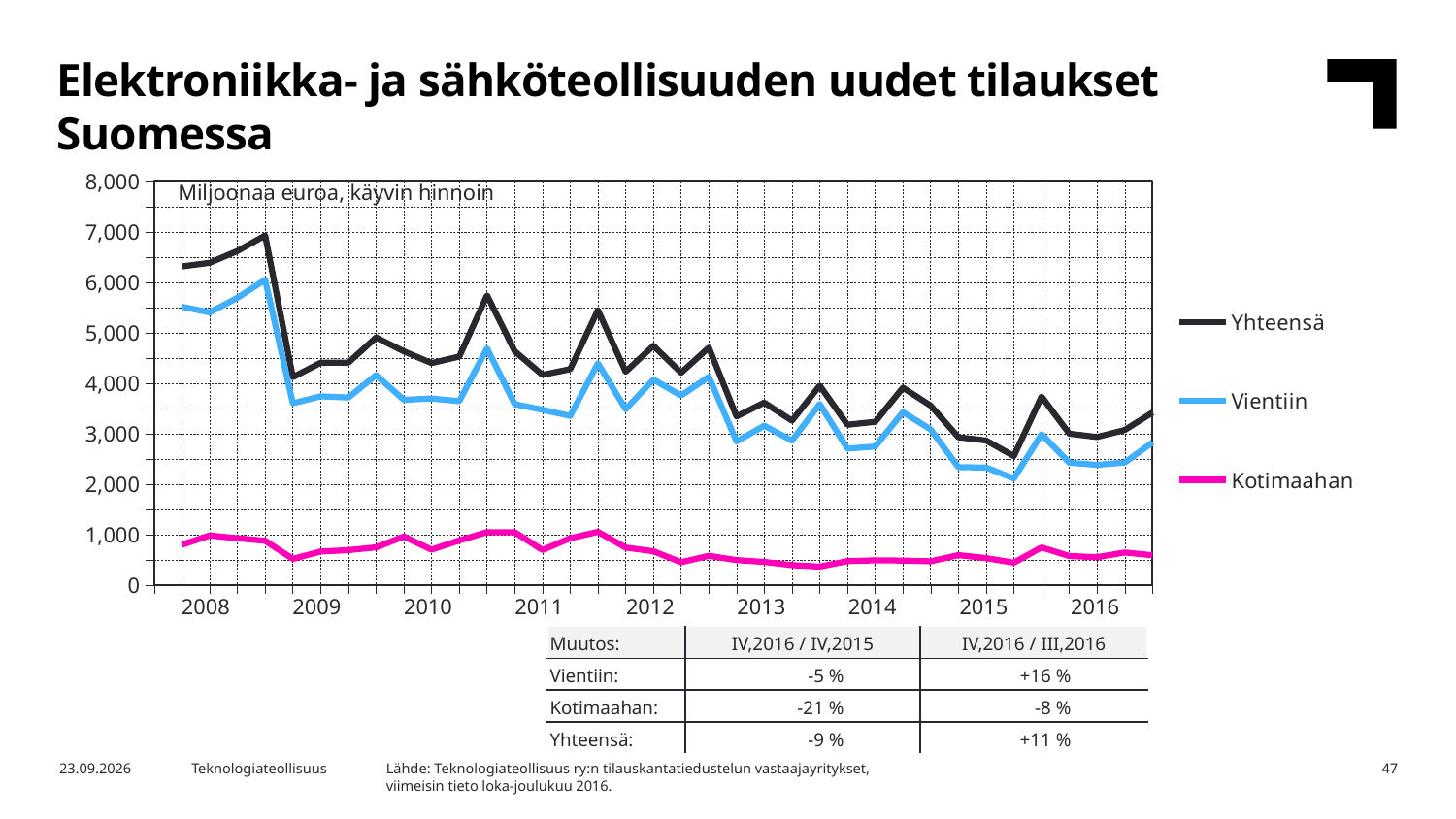
In 2016, which series is larger, Vientiin or Kotimaahan? Vientiin How many series does the legend list? 3 Is the value for Kotimaahan at the start of 2008 greater or less than 2,000? less Does the Yhteensä series overall rise or fall from 2008 to 2016? fall Is the value for Vientiin at the end of 2016 greater or less than 4,000? less What unit label is shown inside the chart area? Miljoonaa euroa, käyvin hinnoin How many year labels are shown on the x axis? 9 Which series has the lowest values throughout the chart? Kotimaahan What are the series names listed in the legend? Yhteensä, Vientiin, Kotimaahan What kind of chart is shown on the slide? line chart Which series has the highest values throughout the chart? Yhteensä Is the value for Yhteensä at the start of 2008 greater or less than 6,000? greater